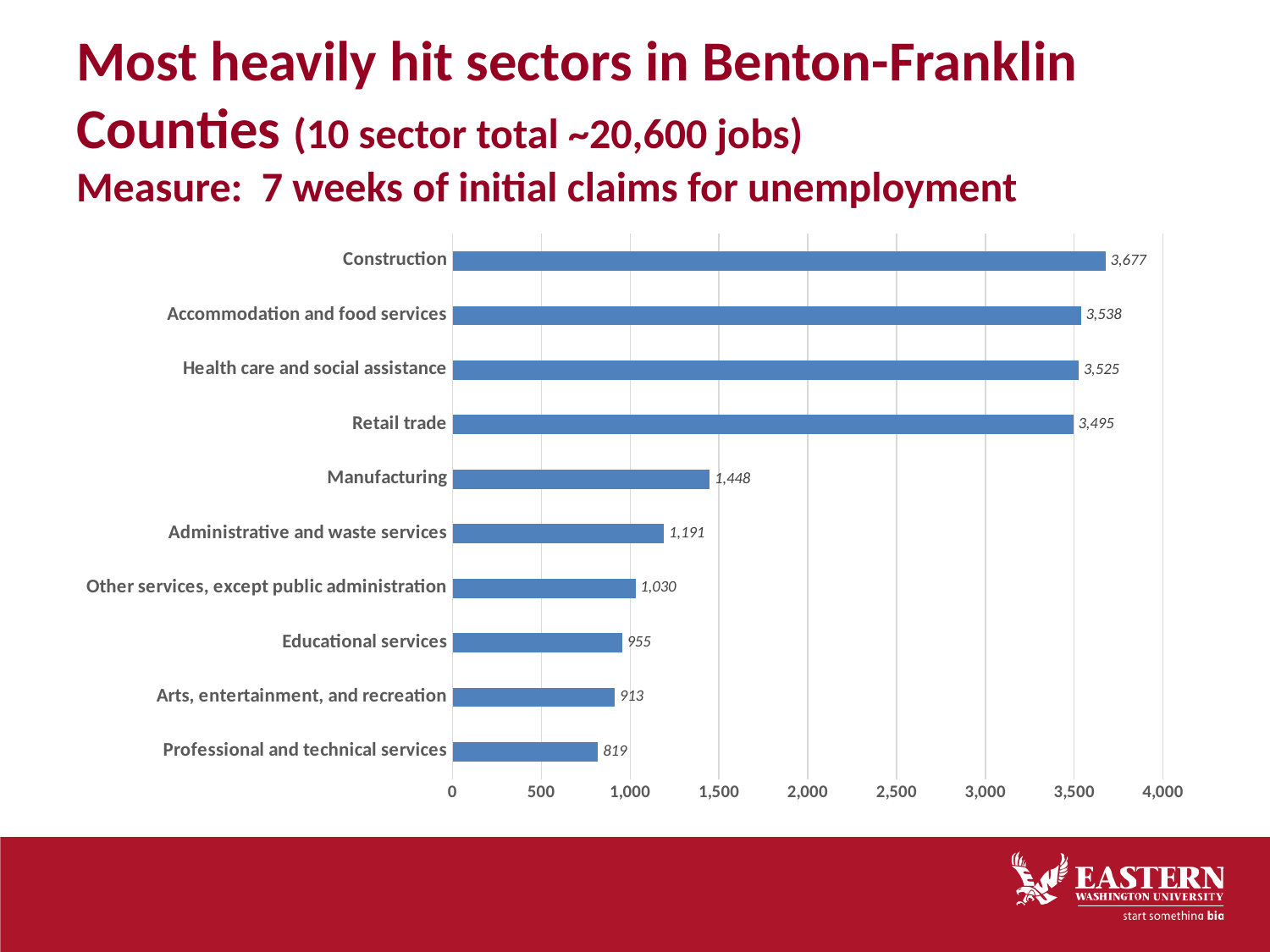
What is the difference between the values for Construction and Professional and technical services? 2,858 What is the value for Construction? 3,677 What kind of chart is shown on the slide? Bar chart Is the value for Other services, except public administration greater or less than 1,000? greater What is the maximum value shown on the horizontal axis? 4,000 What is the value for Manufacturing? 1,448 What is the value for Educational services? 955 What is the difference between the values for Manufacturing and Administrative and waste services? 257 Which sector has the highest value? Construction How many sectors are shown in the chart? 10 Which sector has the lowest value? Professional and technical services Which is larger, the value for Retail trade or the value for Manufacturing? Retail trade